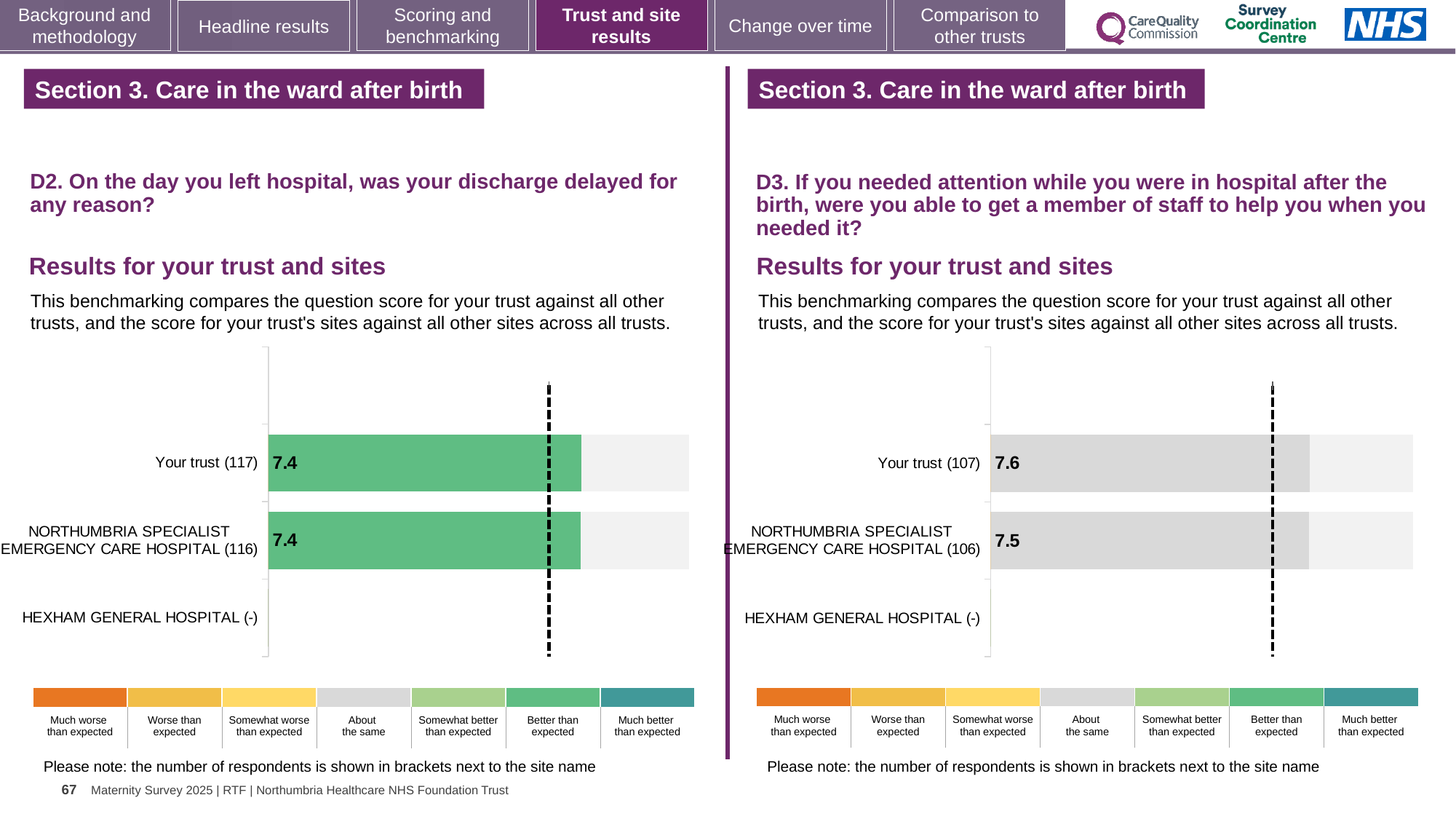
In the right chart (D3, getting a member of staff to help), what is the score for NORTHUMBRIA SPECIALIST EMERGENCY CARE HOSPITAL? 7.5 In the right chart (D3, getting a member of staff to help), what is the score for Your trust? 7.6 In the left chart (D2, discharge delayed), what is the score for NORTHUMBRIA SPECIALIST EMERGENCY CARE HOSPITAL? 7.4 In the left chart (D2, discharge delayed), what is the score for Your trust? 7.4 In the right chart (D3), which benchmark category does the colour of the bars correspond to according to the legend? About the same How many categories (rows) are listed on the left chart (D2)? 3 In the left chart (D2), which benchmark category does the colour of the bars correspond to according to the legend? Better than expected In the left chart (D2), how many respondents are shown in brackets for Your trust? 117 In the right chart (D3), how many respondents are shown in brackets for NORTHUMBRIA SPECIALIST EMERGENCY CARE HOSPITAL? 106 In the right chart (D3), what is the difference between the score for Your trust and the score for NORTHUMBRIA SPECIALIST EMERGENCY CARE HOSPITAL? 0.1 In the right chart (D3), which has the higher score: Your trust or NORTHUMBRIA SPECIALIST EMERGENCY CARE HOSPITAL? Your trust What kind of chart is used on the right side of the slide (D3)? Bar chart